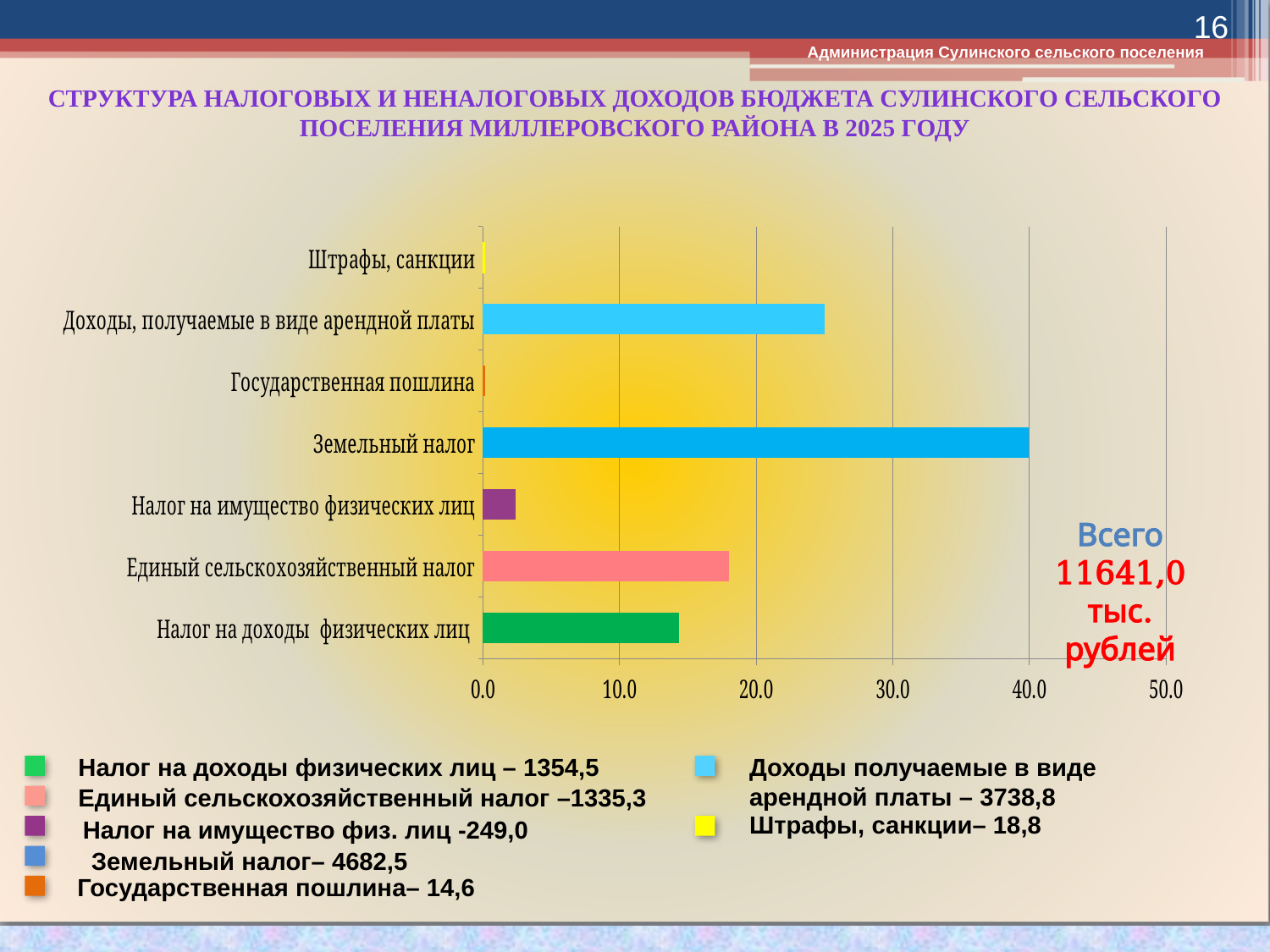
What type of chart is shown on the slide? bar chart Which category has the longest bar in the chart? Земельный налог Is the value for Единый сельскохозяйственный налог greater or less than 20.0? less Is the value for Земельный налог greater or less than 30.0? greater According to the legend below the chart, what is the amount for Земельный налог? 4682,5 According to the legend below the chart, what is the amount for Штрафы, санкции? 18,8 Which bar is longer: Доходы, получаемые в виде арендной платы or Единый сельскохозяйственный налог? Доходы, получаемые в виде арендной платы How many categories are plotted in the chart? 7 Is the value for Налог на имущество физических лиц greater or less than 10.0? less What total amount (Всего) is stated on the chart? 11641,0 тыс. рублей Which category has the shortest bar in the chart? Государственная пошлина